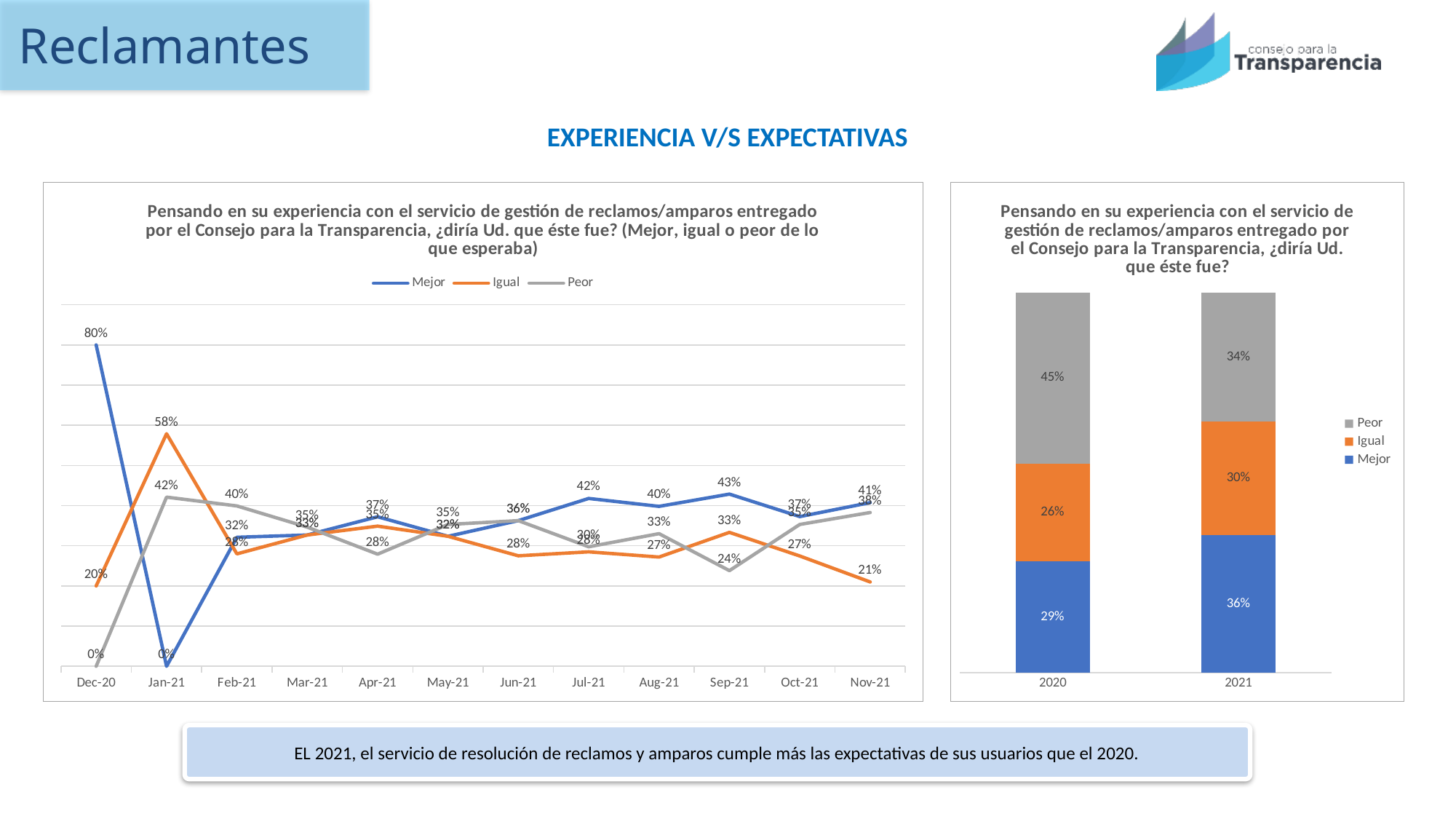
How many series does the legend of the right-hand chart list? 3 In the right-hand stacked bar chart, what percentage is shown for Mejor in 2021? 36% How many months are plotted on the x axis of the left-hand line chart? 12 In the left-hand line chart, what is the value of Igual in Nov-21? 21% In the left-hand line chart, what is the value of Mejor in Dec-20? 80% In the left-hand line chart, what is the value of Igual in Jan-21? 58% In the right-hand stacked bar chart, what percentage is shown for Peor in 2020? 45% In the right-hand stacked bar chart, by how many percentage points did Mejor increase from 2020 to 2021? 7 percentage points In the right-hand stacked bar chart, what is the total of the three segments of the 2020 bar? 100% In the left-hand line chart, in which month does Igual reach its highest value? Jan-21 In the left-hand line chart, which is larger in Sep-21, Mejor or Igual? Mejor What kind of chart is the left-hand chart (Dec-20 to Nov-21)? Line chart